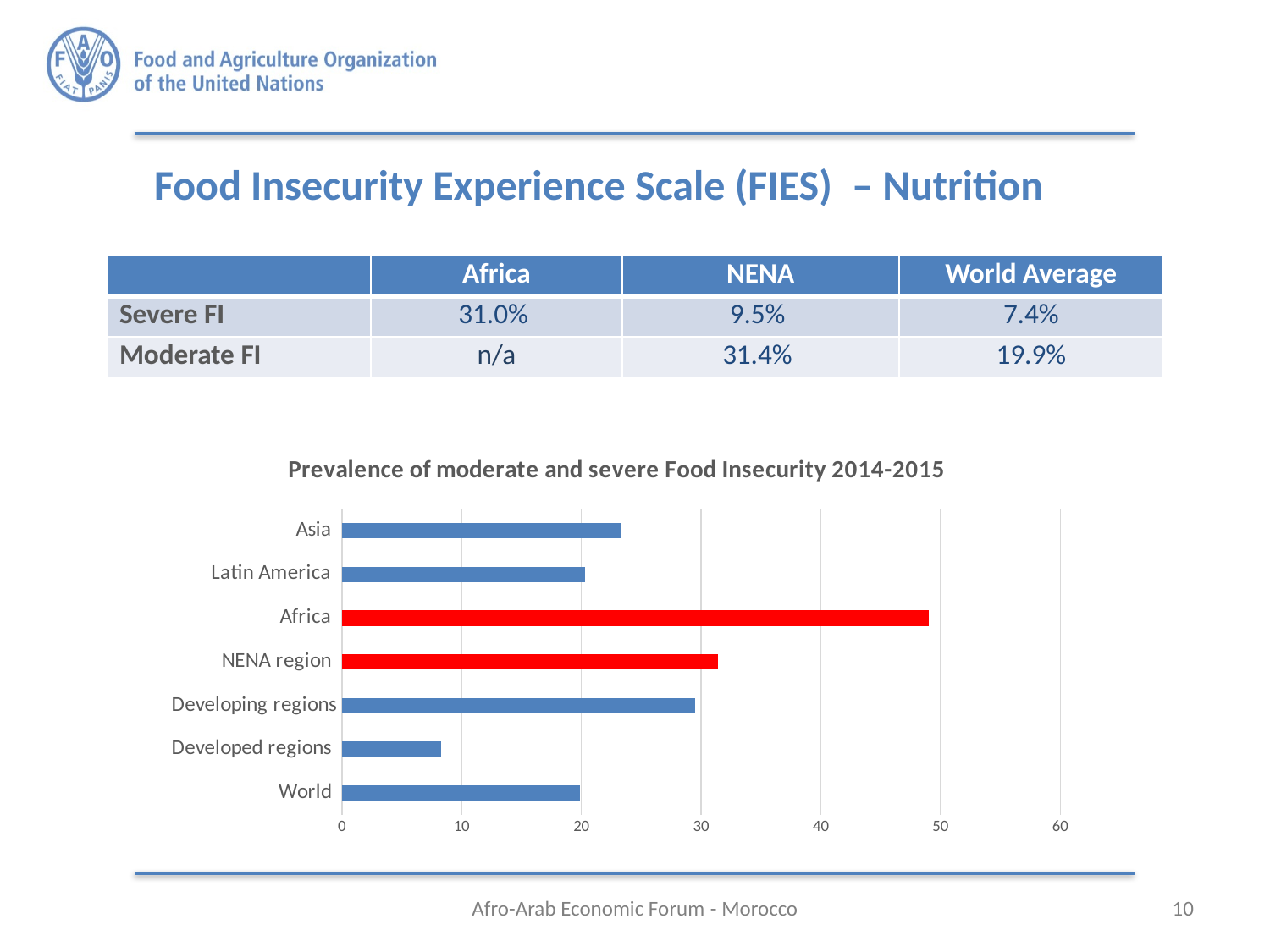
Is the value for World greater or less than 30? less Is the value for Developing regions greater or less than 20? greater Is the value for Developed regions greater or less than 10? less Which bars in the chart are coloured red? Africa and NENA region Which region has the lowest prevalence in the chart? Developed regions Which region has the highest prevalence in the chart? Africa How many regions are plotted in the chart? 7 What is the title of the chart? Prevalence of moderate and severe Food Insecurity 2014-2015 What type of chart is shown on the slide? bar chart Which is larger, the value for Africa or the value for NENA region? Africa